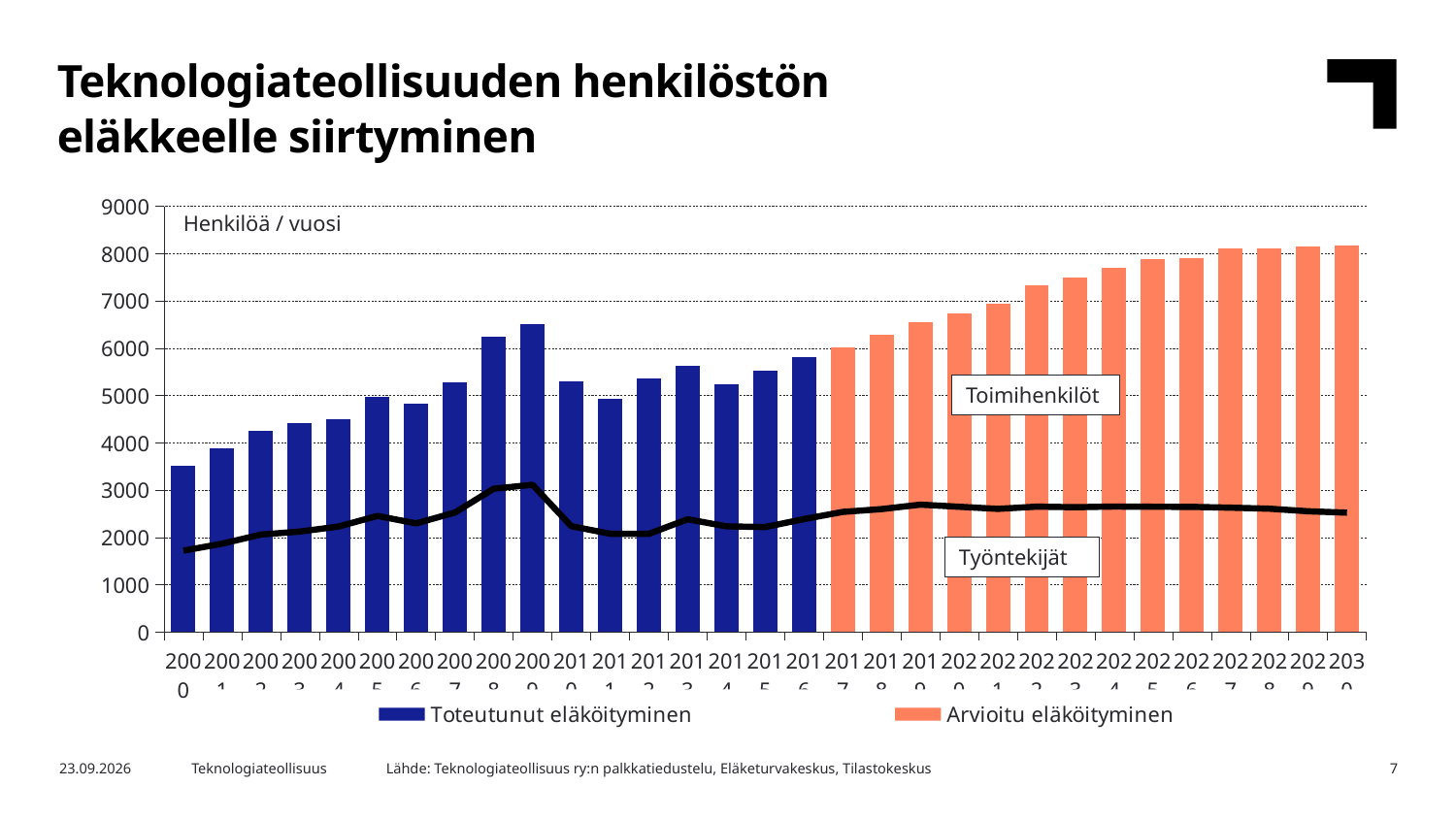
What unit label is shown at the top of the y axis? Henkilöä / vuosi What are the two legend entries? Toteutunut eläköityminen and Arvioitu eläköityminen Is the bar for 2000 greater or less than 4000? less Which year has the lowest bar? 2000 Which bar is taller, 2008 or 2009? 2009 Is the bar for 2020 greater or less than 6000? greater How many series does the legend list? 2 Is the bar for 2009 greater or less than 6000? greater What kind of chart is shown on the slide? Combination bar and line chart Do the Arvioitu eläköityminen bars rise or fall from 2017 to 2030? rise How many years (bars) are shown on the x axis? 31 Which bar is taller, 2015 or 2016? 2016